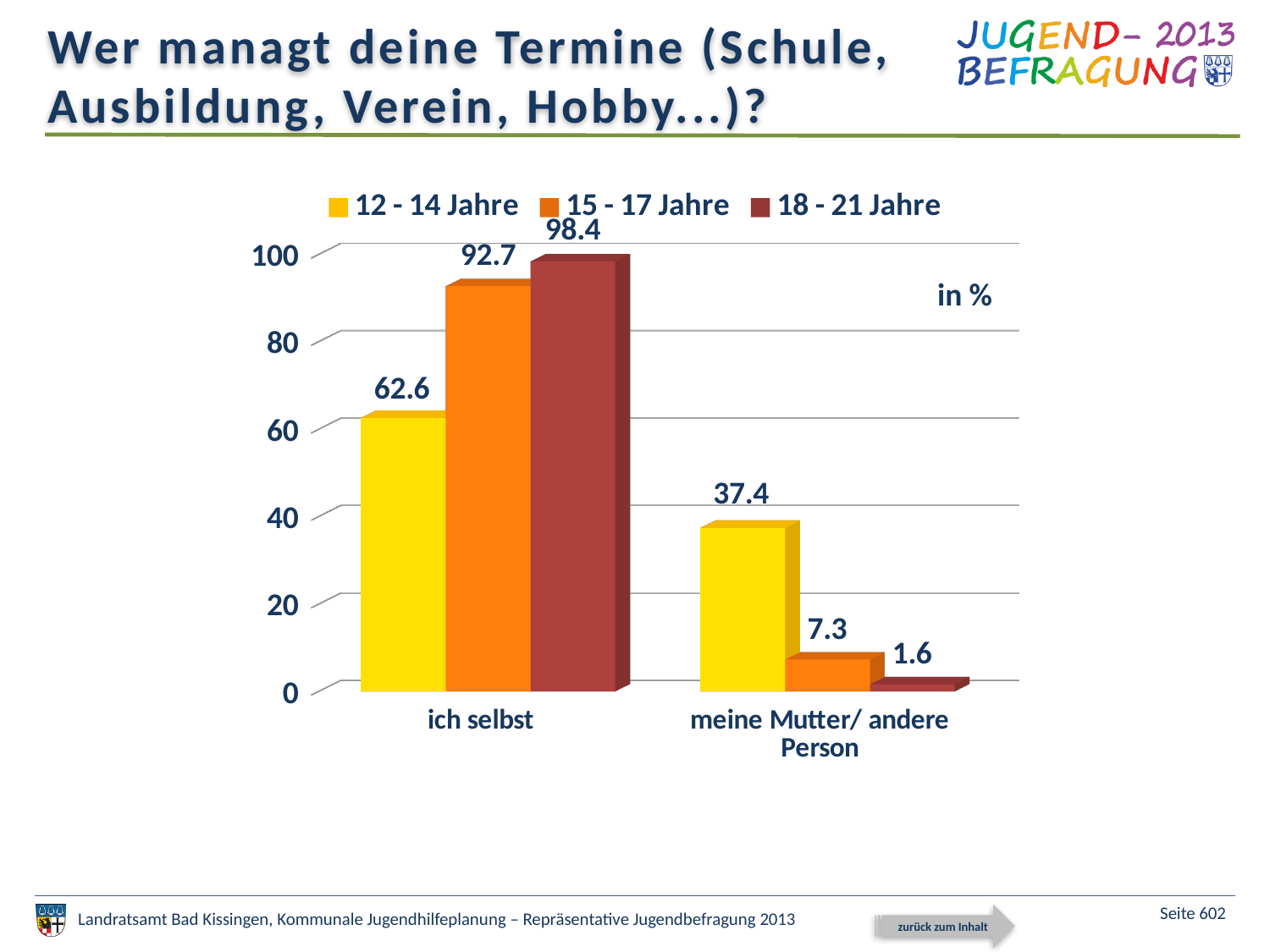
Which age group has the highest value in the 'ich selbst' category? 18 - 21 Jahre What is the difference between the 12 - 14 Jahre values for 'ich selbst' and 'meine Mutter/ andere Person'? 25.2 What unit is indicated for the values in the chart? in % Which is larger: the 15 - 17 Jahre value for 'meine Mutter/ andere Person' or the 18 - 21 Jahre value for 'meine Mutter/ andere Person'? 15 - 17 Jahre What kind of chart is shown on the slide? bar chart Is the 12 - 14 Jahre value for 'meine Mutter/ andere Person' greater or less than 40? less What is the value for the 15 - 17 Jahre series in the 'ich selbst' category? 92.7 Which age group has the lowest value in the 'meine Mutter/ andere Person' category? 18 - 21 Jahre What is the value for the 12 - 14 Jahre series in the 'ich selbst' category? 62.6 How many categories are shown on the x axis? 2 What is the value for the 18 - 21 Jahre series in the 'meine Mutter/ andere Person' category? 1.6 How many series does the legend list? 3